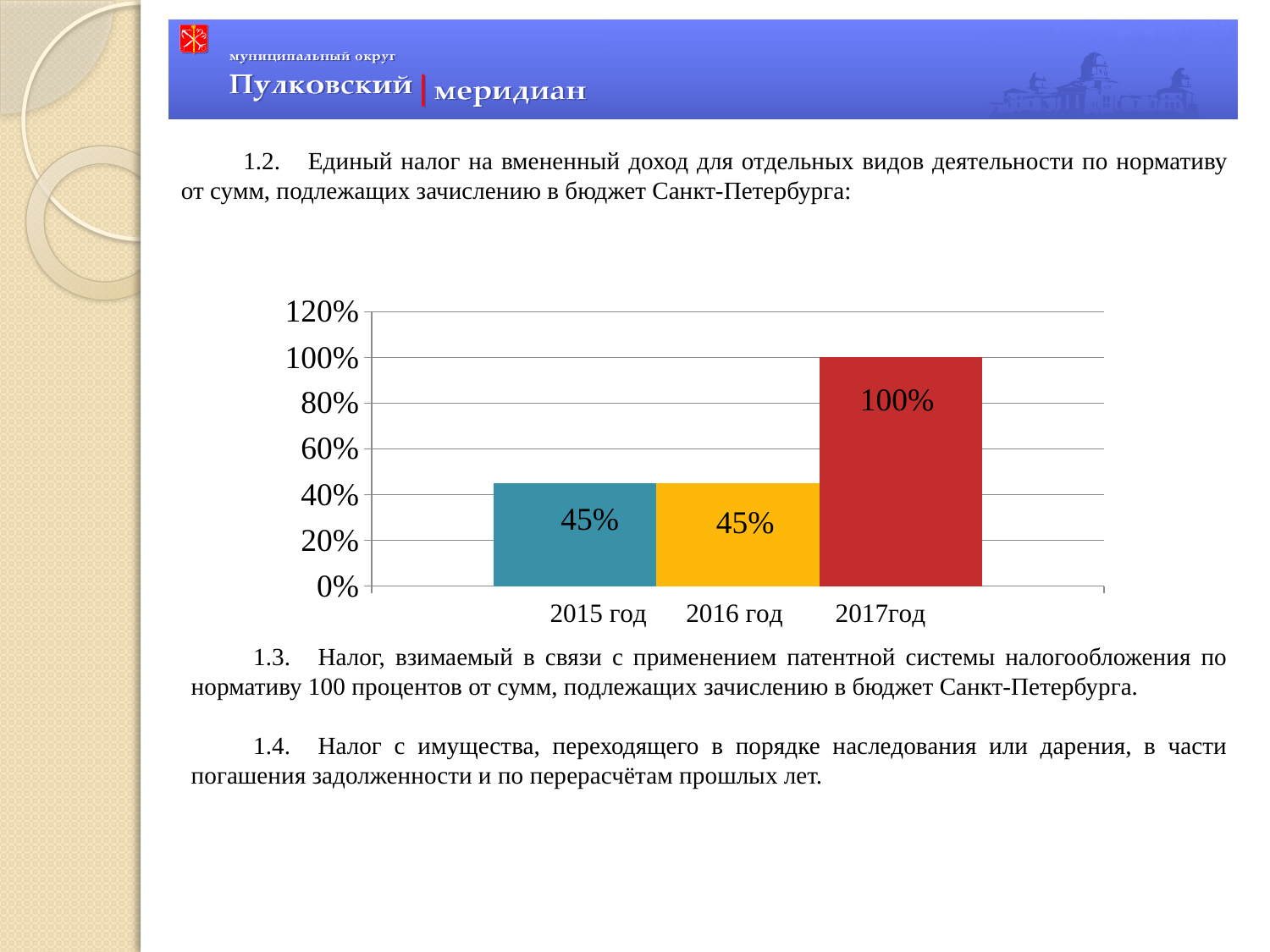
Which year has the highest value? 2017год What kind of chart is shown on the slide? bar chart What is the value for 2016 год? 45% What is the difference between the values for 2017год and 2016 год? 55% How many categories are shown on the x axis? 3 Do the values rise or fall from 2016 год to 2017год? rise What is the value for 2017год? 100% Is the value for 2016 год greater or less than 60%? less What colour is the bar for 2017год? red What is the value for 2015 год? 45% Which is larger, the value for 2015 год or the value for 2017год? 2017год Is the value for 2017год greater or less than 80%? greater